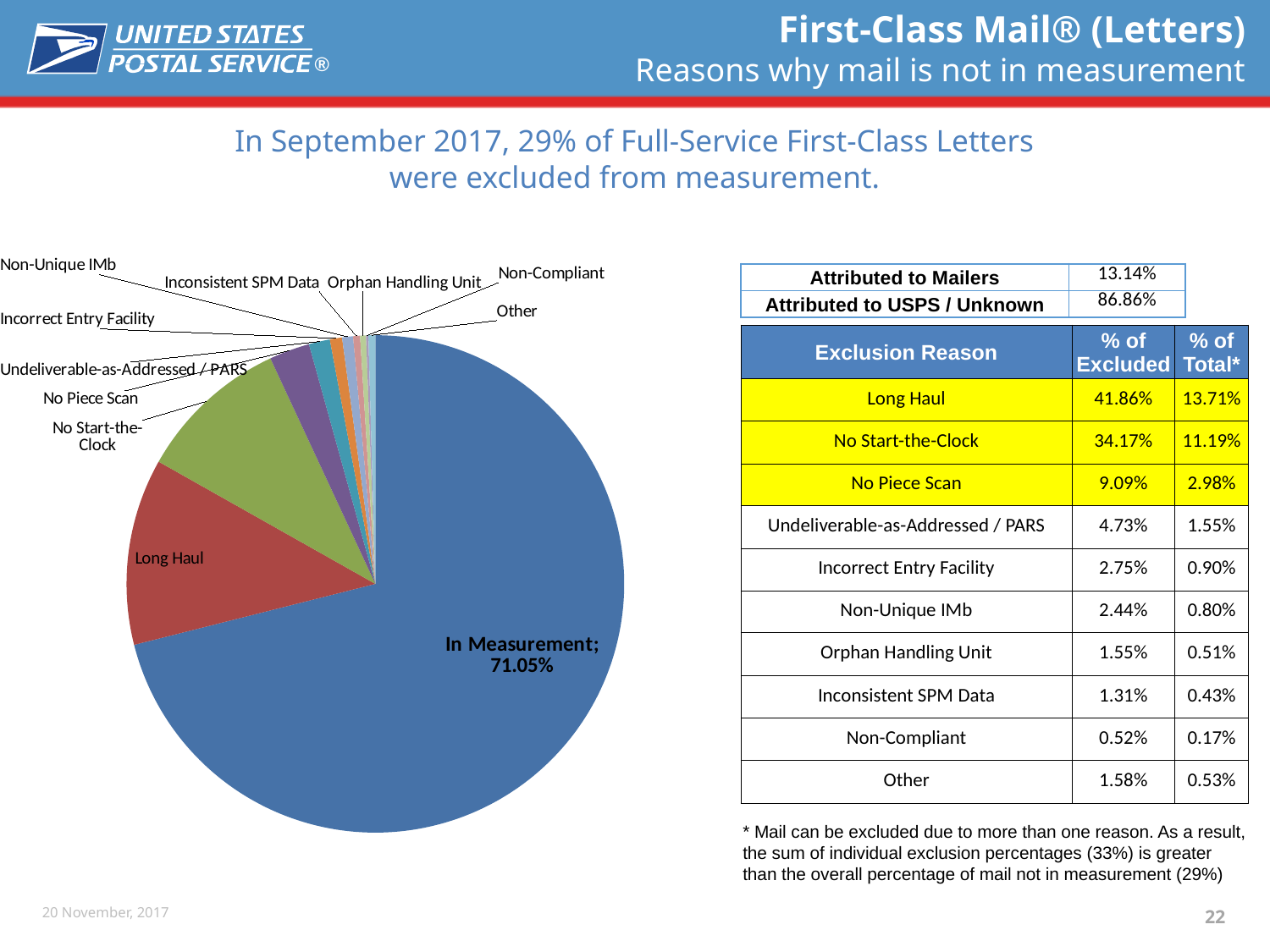
Which slice of the pie chart is the largest? In Measurement What is the value shown for the In Measurement slice of the pie chart? 71.05% What kind of chart is shown on the slide? pie chart How many slices does the pie chart have? 11 Which slice of the pie chart is the second largest? Long Haul What colour is the In Measurement slice of the pie chart? blue What colour is the Long Haul slice of the pie chart? red What share of the pie does the In Measurement slice represent? 71.05% In the pie chart, which slice is larger: Long Haul or No Piece Scan? Long Haul In the pie chart, which slice is larger: In Measurement or Long Haul? In Measurement In the pie chart, which slice is larger: No Start-the-Clock or Undeliverable-as-Addressed / PARS? No Start-the-Clock